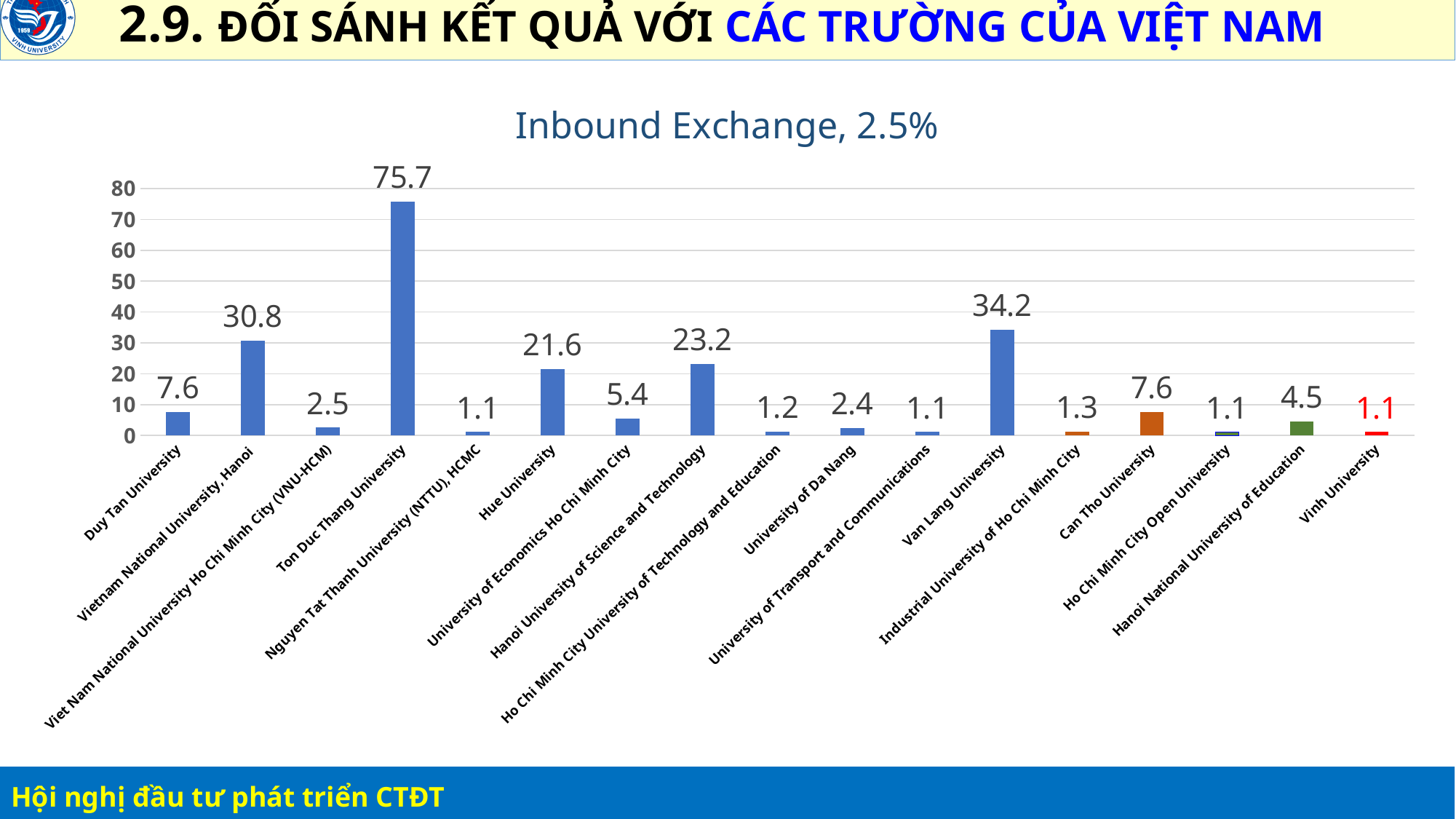
What is the value for Ton Duc Thang University? 75.7 What kind of chart is shown on the slide? bar chart Which is larger, the value for Hue University or the value for Hanoi University of Science and Technology? Hanoi University of Science and Technology What is the value for Van Lang University? 34.2 What is the difference between the values for Van Lang University and Vietnam National University, Hanoi? 3.4 Which university has the highest value? Ton Duc Thang University What is the difference between the values for Hanoi University of Science and Technology and Hue University? 1.6 Is the value for Ton Duc Thang University greater or less than 70? greater What is the title of the chart? Inbound Exchange, 2.5% What is the value for Vinh University? 1.1 What is the value for Hanoi National University of Education? 4.5 How many universities are shown on the chart? 17